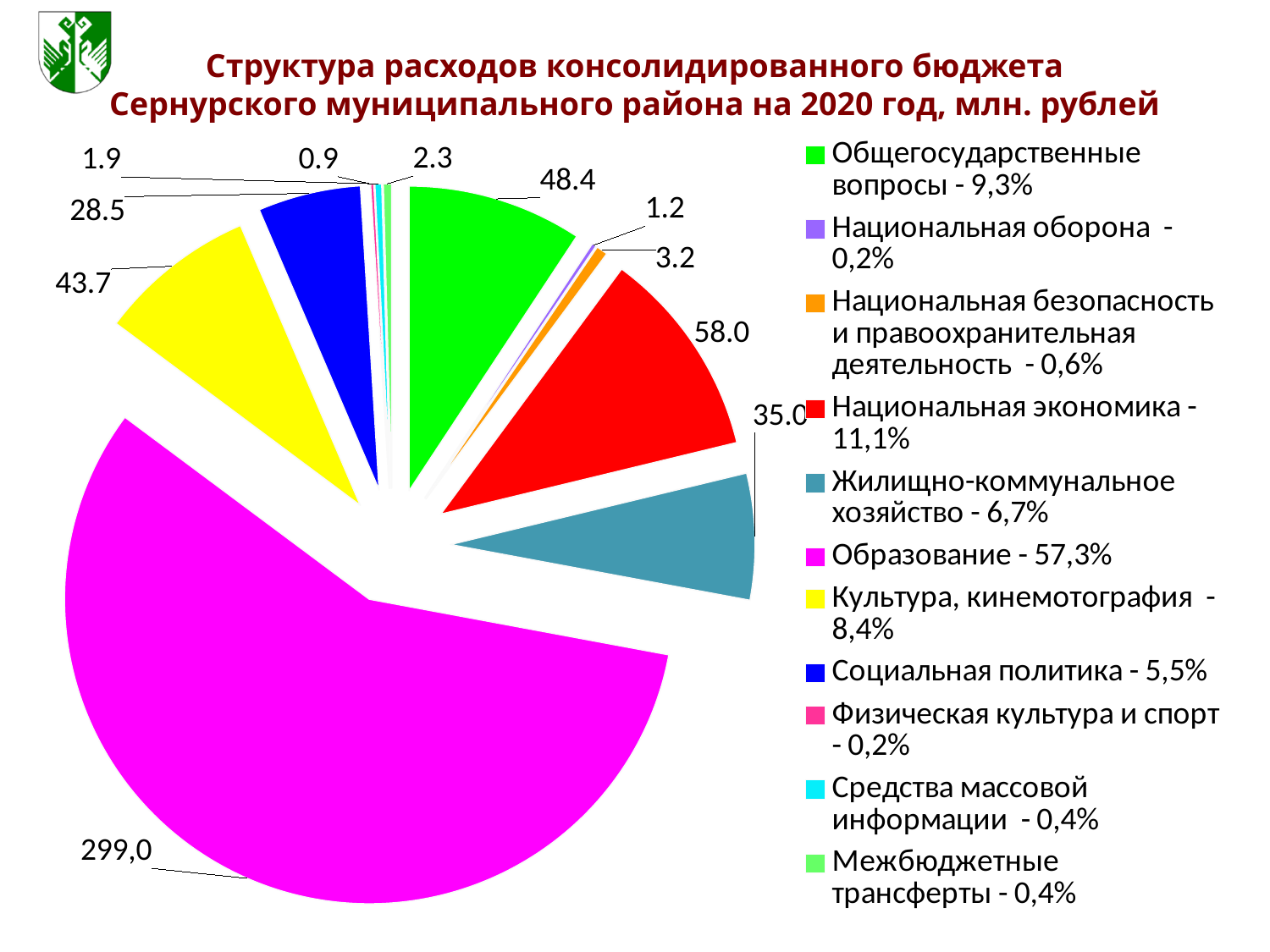
What kind of chart is shown on the slide? Pie chart What is the value shown for the Общегосударственные вопросы slice? 48.4 What share of the pie does Образование account for, according to the legend? 57,3% What is the difference between the values for Национальная экономика and Общегосударственные вопросы? 9.6 What is the value shown for the Образование slice? 299,0 What is the value shown for the Культура, кинемотография slice? 43.7 Which category has the largest slice of the pie? Образование What is the value shown for the Жилищно-коммунальное хозяйство slice? 35.0 What is the value shown for the Социальная политика slice? 28.5 How many categories does the legend list? 11 What is the value shown for the Национальная экономика slice? 58.0 Which is larger, the value for Культура, кинемотография or the value for Социальная политика? Культура, кинемотография